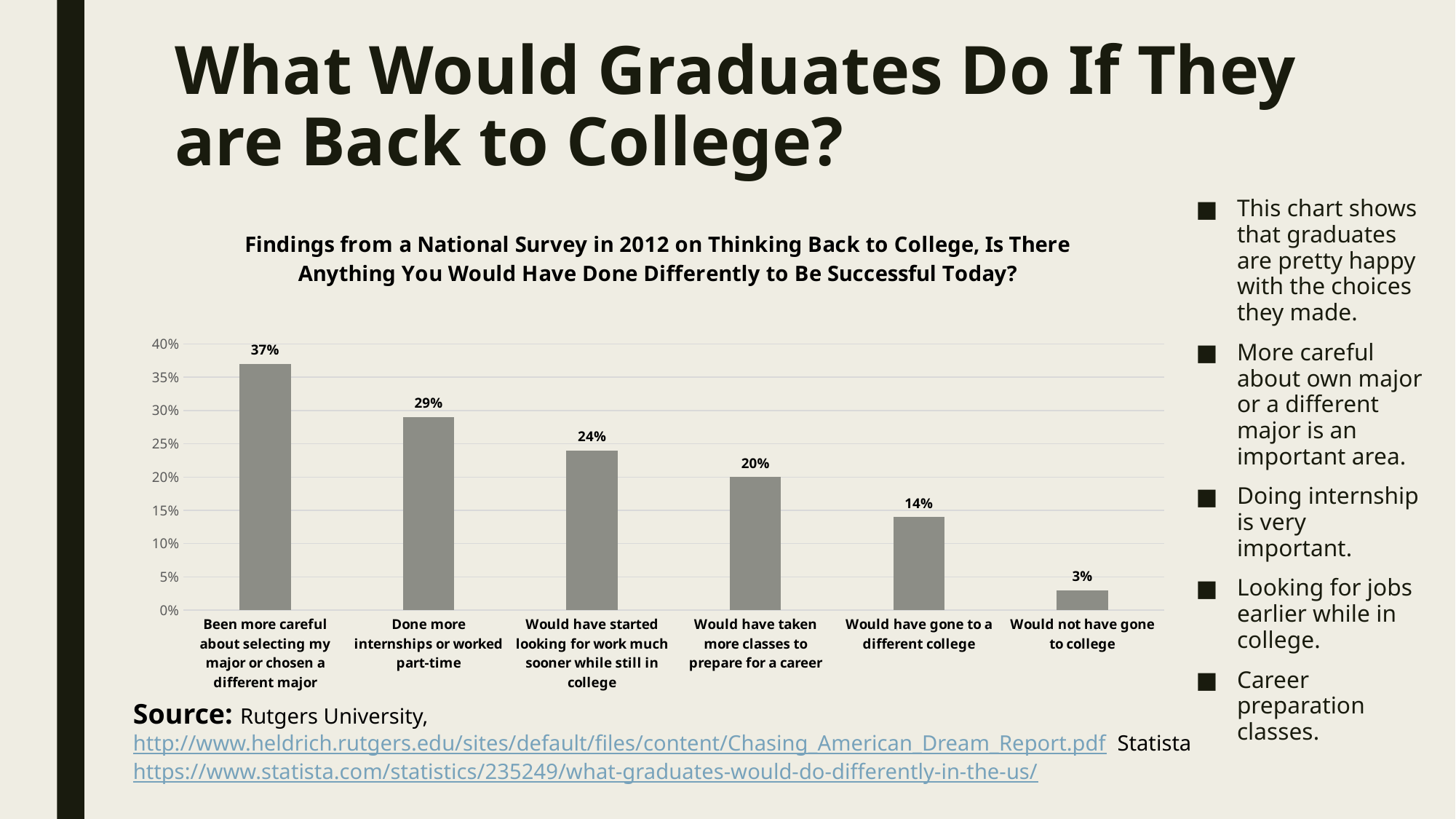
What is the highest value shown on the vertical axis? 40% What is the difference between "Done more internships or worked part-time" and "Would have gone to a different college"? 15% What percentage of graduates said they would have been more careful about selecting their major or chosen a different major? 37% Which is larger: "Would have taken more classes to prepare for a career" or "Would have gone to a different college"? Would have taken more classes to prepare for a career Which category has the lowest value? Would not have gone to college What percentage would have started looking for work much sooner while still in college? 24% Do the values rise or fall from left to right across the categories? Fall What is the value for "Would not have gone to college"? 3% Which category has the highest value? Been more careful about selecting my major or chosen a different major What kind of chart is shown on the slide? Bar chart What is the value for "Done more internships or worked part-time"? 29% How many categories are shown in the chart? 6